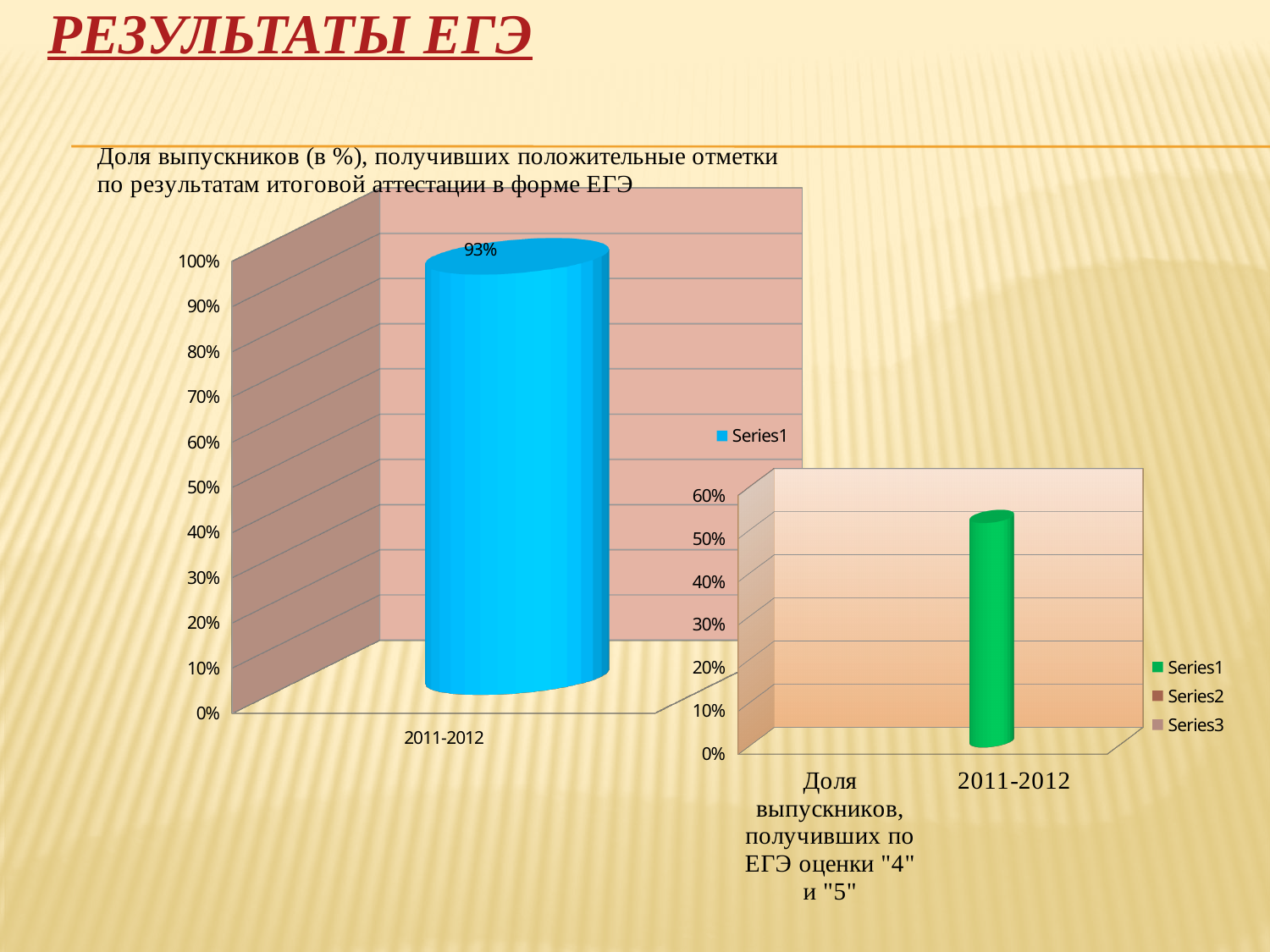
How many series does the legend of the left chart list? 1 In the right chart, is the value of the green bar for 2011-2012 greater or less than 40%? greater What colour is the bar in the right chart? green How many categories are plotted in the left chart? 1 What kind of chart is the right chart on the slide? bar chart Which chart shows the higher value for 2011-2012, the left chart or the right chart? the left chart What kind of chart is the left chart on the slide? bar chart How many series does the legend of the right chart list? 3 In the left chart (Доля выпускников, получивших положительные отметки), what value is shown for 2011-2012? 93% In the left chart, is the value for 2011-2012 greater or less than 90%? greater What are the legend entries of the right chart? Series1, Series2, Series3